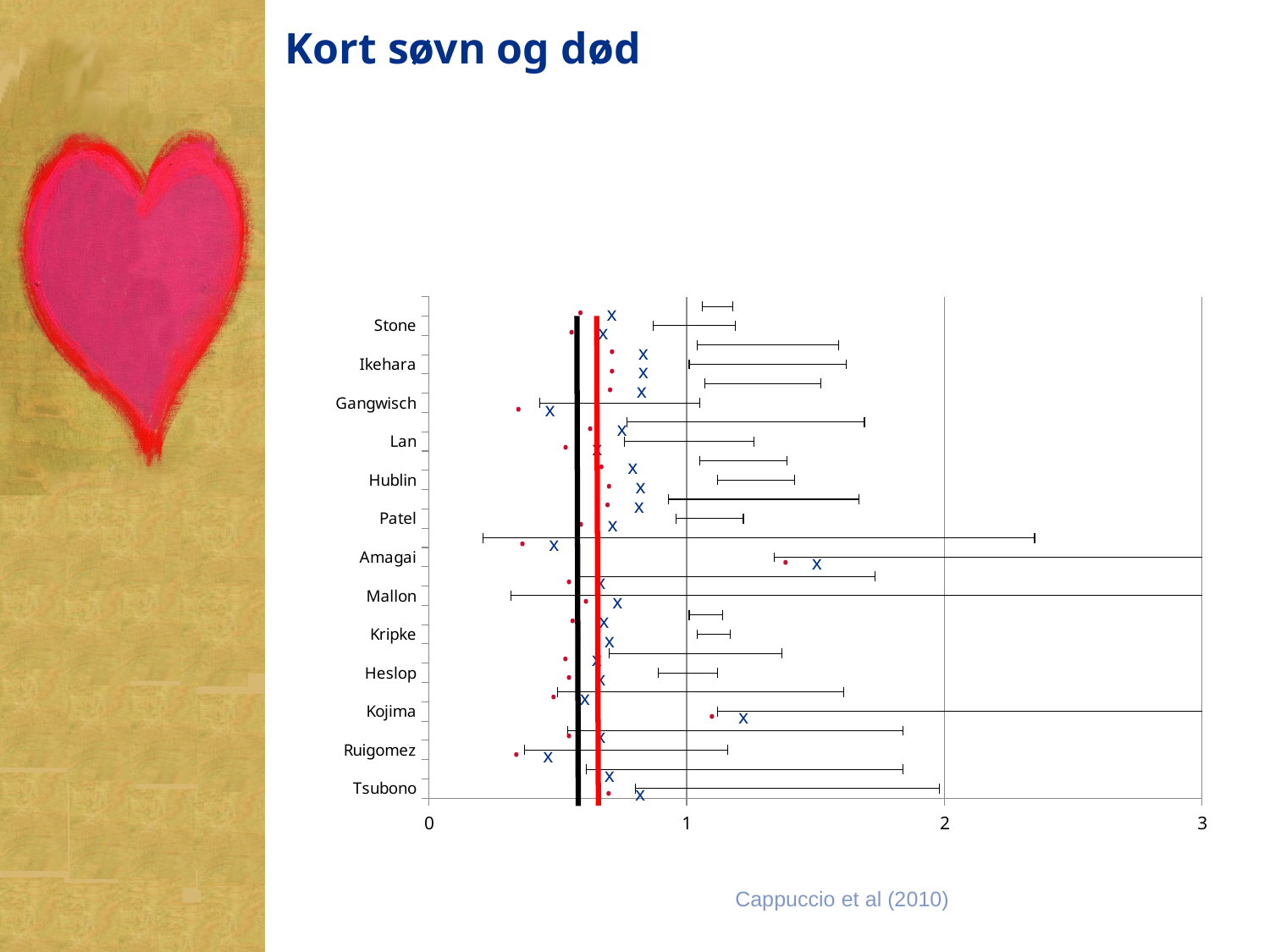
Are the blue X markers for Stone greater or less than 1? less Is the vertical black line on the chart positioned at a value greater or less than 1? less Are the blue X markers for Hublin greater or less than 1? less What kind of chart is shown on the slide? scatter chart What is the highest value shown on the horizontal axis of the chart? 3 What is the title of the slide containing the chart? Kort søvn og død Which study name appears at the bottom of the vertical axis? Tsubono How many study names are labelled on the vertical axis of the chart? 13